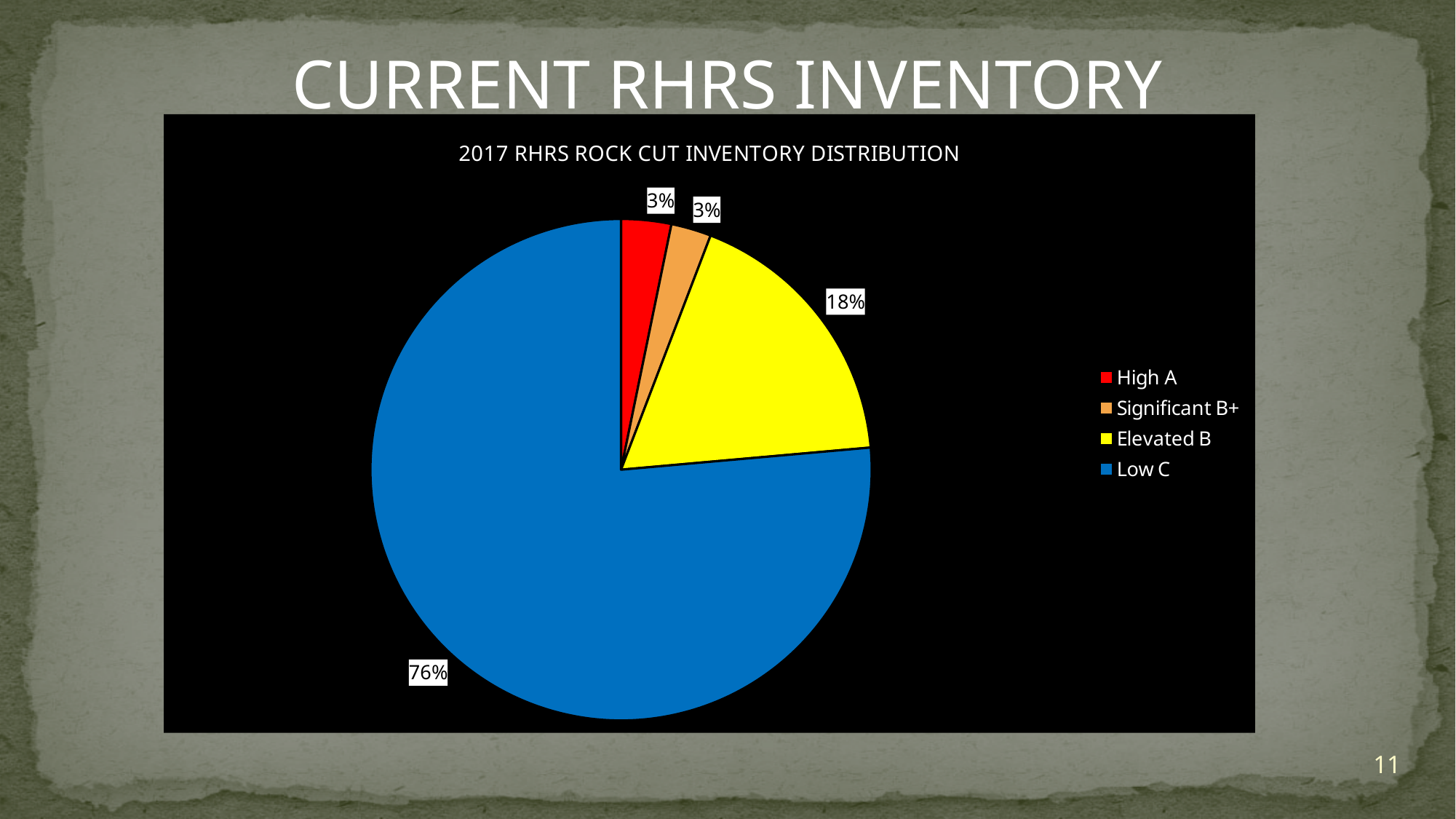
What is the title of the chart? 2017 RHRS ROCK CUT INVENTORY DISTRIBUTION What share of the pie does Elevated B represent? 18% Is the share for Low C greater or less than 50%? greater What is the difference between the Low C share and the Elevated B share? 58% Which is larger, the share for Elevated B or the share for High A? Elevated B What share of the pie does Low C represent? 76% What share of the pie does Significant B+ represent? 3% What type of chart is shown on the slide? pie chart What colour represents Elevated B in the chart? yellow Which category has the largest share of the pie? Low C How many categories does the legend list? 4